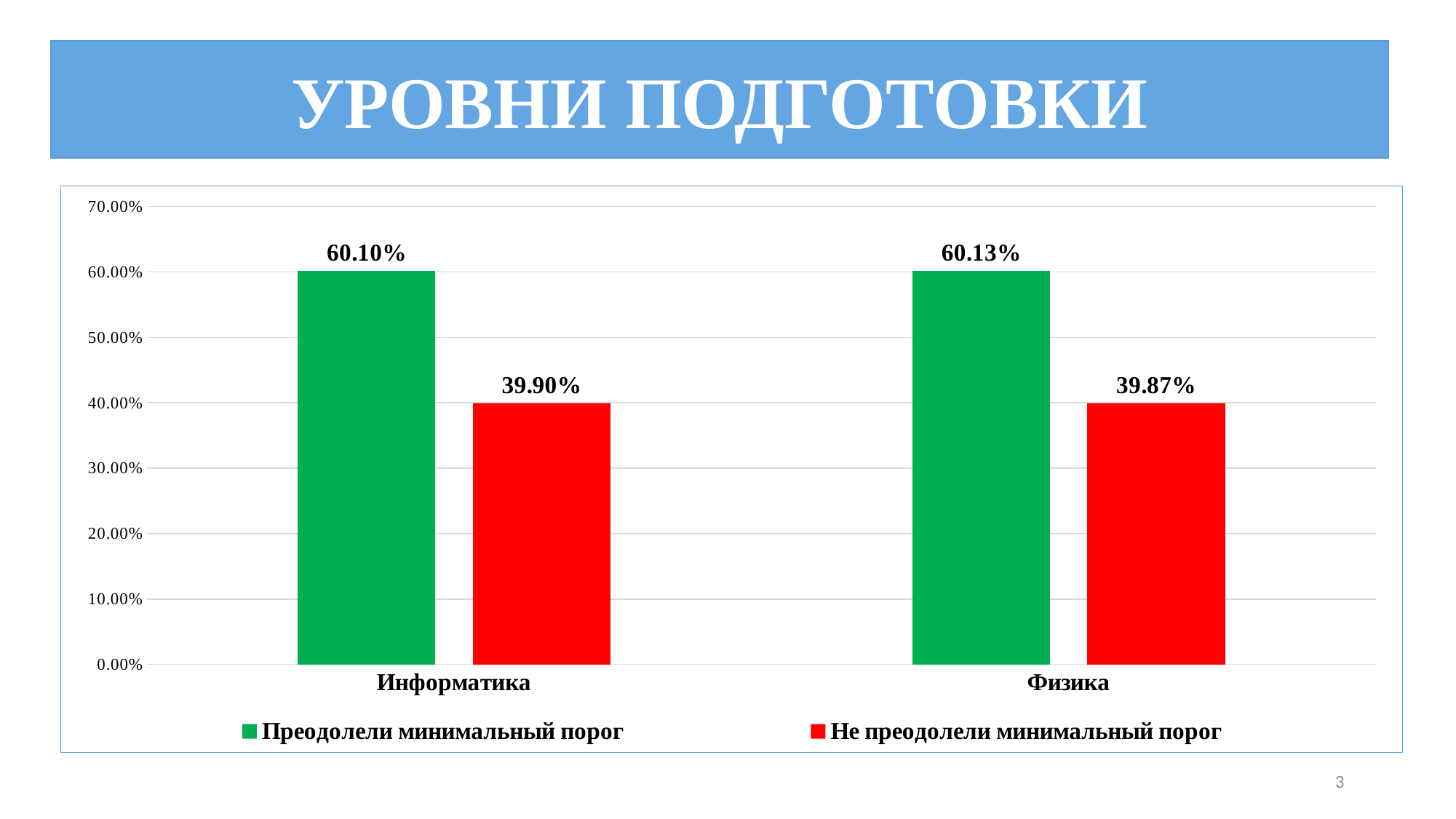
How many categories are shown on the x axis? 2 How many series does the legend list? 2 What colour represents 'Не преодолели минимальный порог' in the legend? red Which bar has the lowest value on the chart? Не преодолели минимальный порог, Физика Is the value for 'Не преодолели минимальный порог' in Информатика greater or less than 50.00%? less What is the value for 'Преодолели минимальный порог' in Информатика? 60.10% What is the value for 'Преодолели минимальный порог' in Физика? 60.13% What is the difference between 'Преодолели минимальный порог' and 'Не преодолели минимальный порог' for Информатика? 20.20% What is the value for 'Не преодолели минимальный порог' in Информатика? 39.90% What kind of chart is shown on the slide? bar chart Which is larger for Физика: 'Преодолели минимальный порог' or 'Не преодолели минимальный порог'? Преодолели минимальный порог What is the value for 'Не преодолели минимальный порог' in Физика? 39.87%